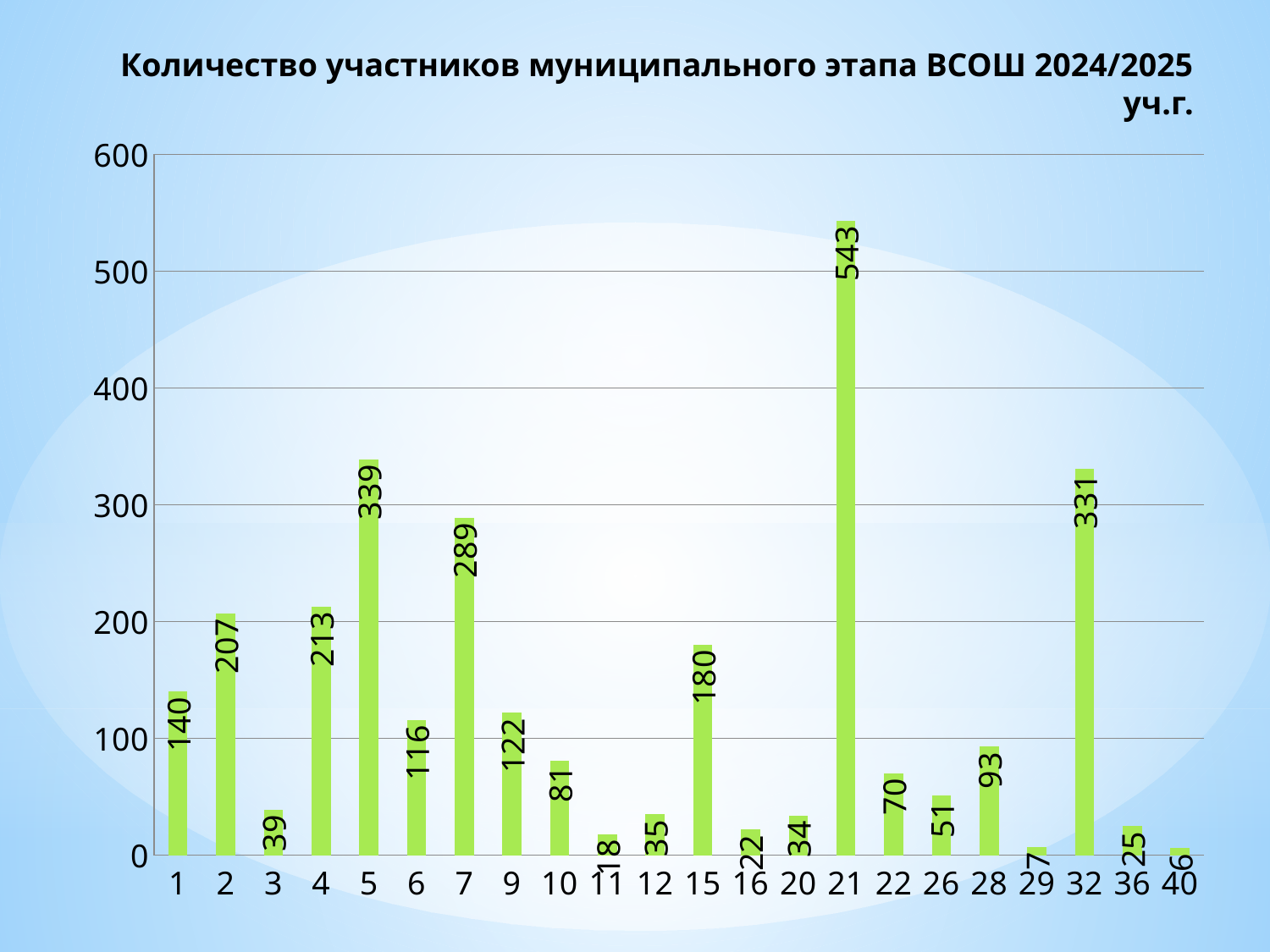
Which category has the lowest value? 40 What is the difference between the values for category 5 and category 32? 8 What is the value for category 21? 543 Is the value for category 28 greater or less than 100? less What is the title of the chart? Количество участников муниципального этапа ВСОШ 2024/2025 уч.г. Which category has the highest value? 21 What is the value for category 7? 289 What is the value for category 36? 25 What is the difference between the values for category 21 and category 15? 363 Which has a larger value, category 2 or category 4? 4 What kind of chart is this? bar chart How many categories are shown on the x axis? 22